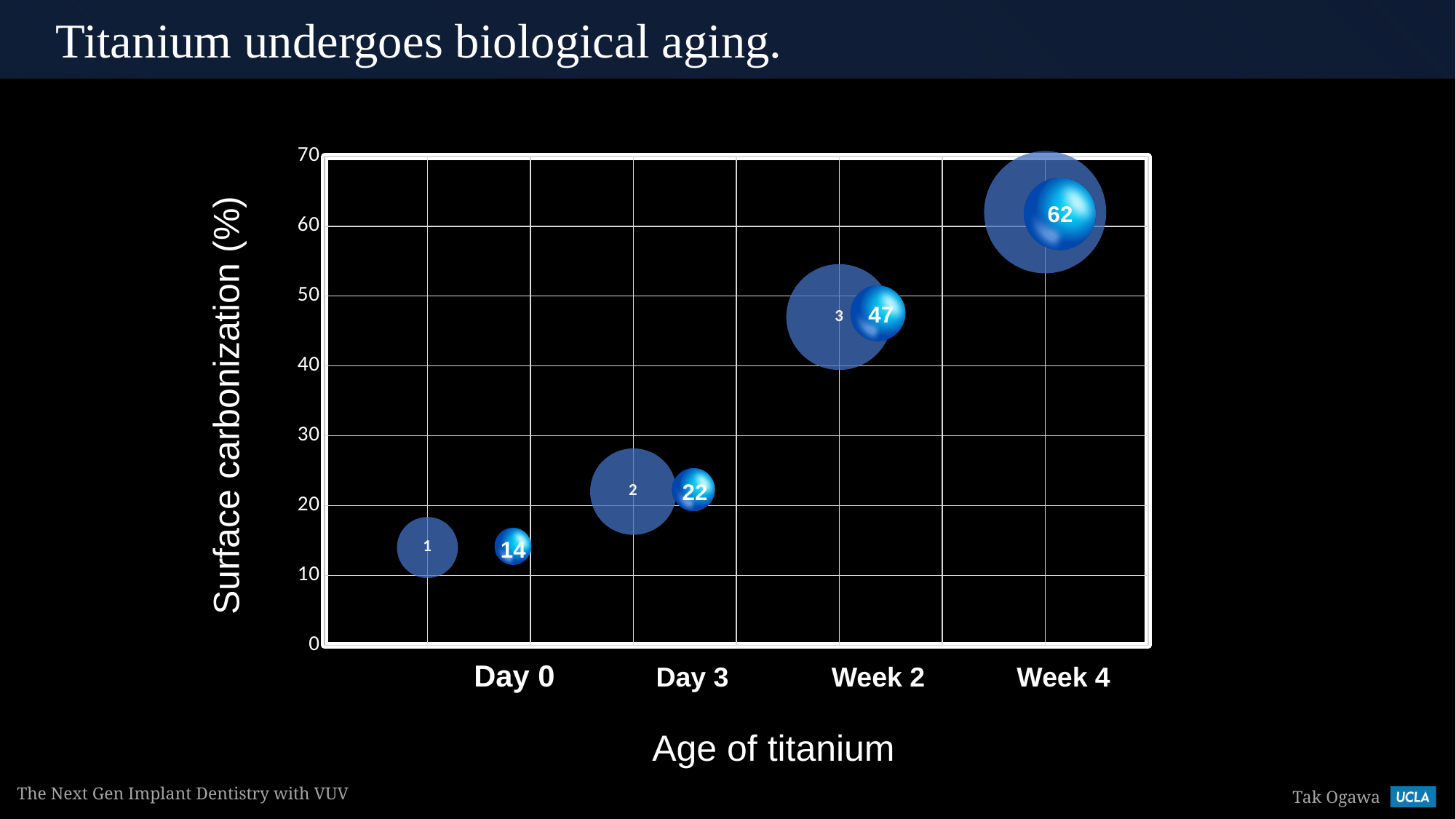
What is the label of the y axis? Surface carbonization (%) Does surface carbonization rise or fall as the age of titanium increases? Rises What is the difference between the surface carbonization values for Day 3 and Day 0? 8 Which age of titanium has the lowest surface carbonization? Day 0 What is the difference between the surface carbonization values for Week 4 and Week 2? 15 What is the surface carbonization value labeled for Day 3? 22 What is the surface carbonization value labeled for Day 0? 14 What is the surface carbonization value labeled for Week 4? 62 What is the surface carbonization value labeled for Week 2? 47 Which has a larger surface carbonization value, Day 3 or Week 2? Week 2 How many age categories are shown on the x axis? 4 Which age of titanium has the highest surface carbonization? Week 4